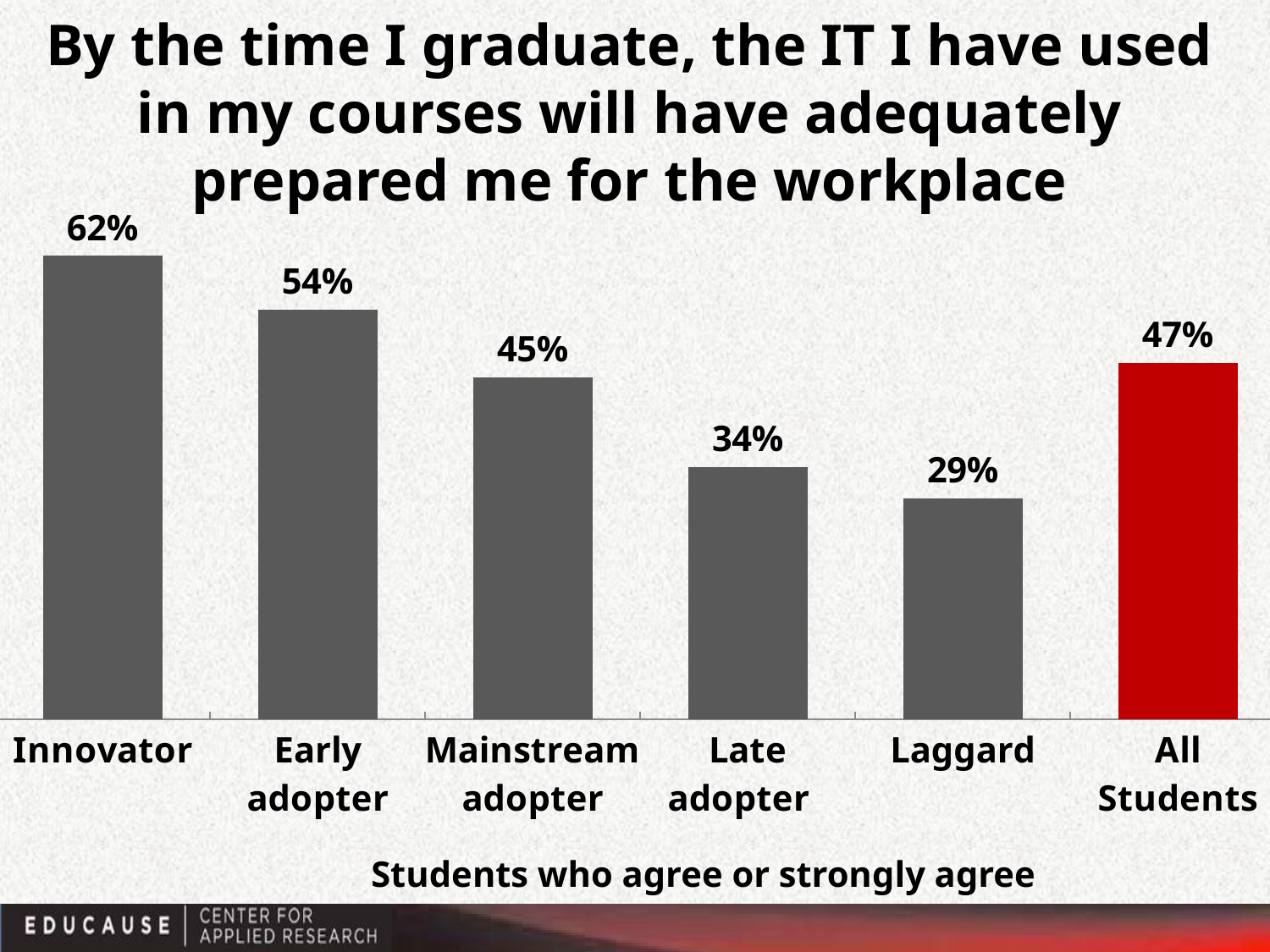
What is the difference between the Innovator and Laggard percentages? 33% What is the value shown for Laggard? 29% What is the value shown for All Students? 47% What percentage of Innovators agree or strongly agree that the IT used in their courses will have adequately prepared them for the workplace? 62% How many categories are shown on the x axis? 6 Which category has the highest percentage of students who agree or strongly agree? Innovator Which category has the lowest percentage of students who agree or strongly agree? Laggard Which bar is coloured red rather than grey? All Students What is the difference between the Early adopter and Mainstream adopter percentages? 9% What kind of chart is shown on the slide? Bar chart Which is larger, the value for Mainstream adopter or the value for All Students? All Students Do the values rise or fall from Innovator to Laggard along the x axis? Fall